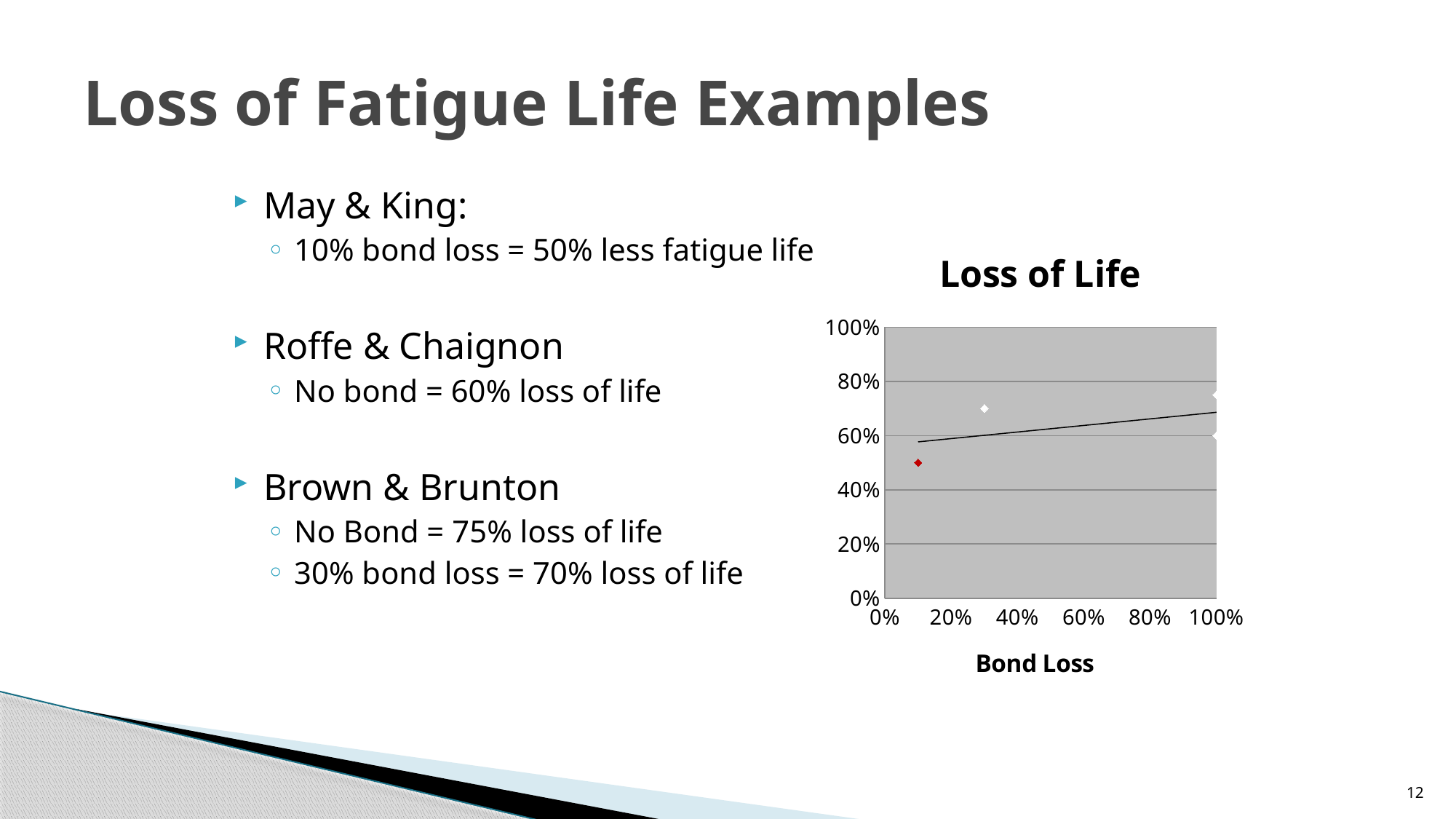
Is the value of the white point at 30% bond loss greater or less than 60%? greater What is the highest value shown on the y axis of the chart? 100% What kind of chart is shown on the slide? scatter chart Is the value of the white point at 30% bond loss greater or less than 80%? less Is the value of the red point at 10% bond loss greater or less than 60%? less What is the title of the chart? Loss of Life Which is larger, the value of the red point at 10% bond loss or the white point at 30% bond loss? the white point at 30% bond loss What is the label of the x axis of the chart? Bond Loss Does the trend line in the chart rise or fall as bond loss increases? rises